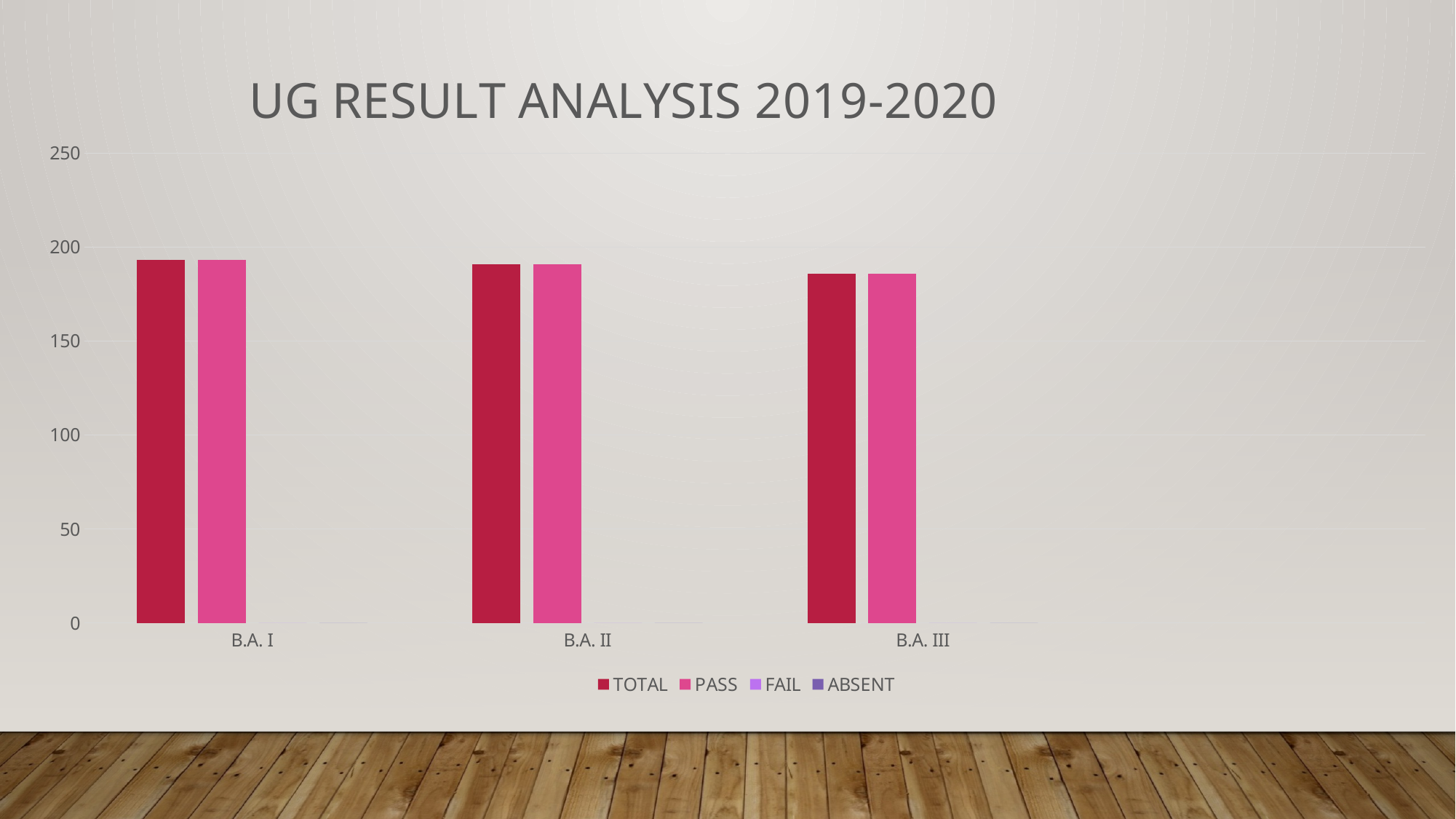
What kind of chart is shown on the slide? bar chart Is the TOTAL value for B.A. II greater or less than 200? less Which is larger, the TOTAL value for B.A. I or the TOTAL value for B.A. III? B.A. I Is the TOTAL value for B.A. I greater or less than 150? greater Which category has the lowest TOTAL value? B.A. III Do the TOTAL values rise or fall from B.A. I to B.A. III? fall Is the PASS value for B.A. III greater or less than 150? greater How many categories are shown on the x axis? 3 How many series does the legend list? 4 Which series are listed in the legend? TOTAL, PASS, FAIL, ABSENT What is the title of the chart? UG RESULT ANALYSIS 2019-2020